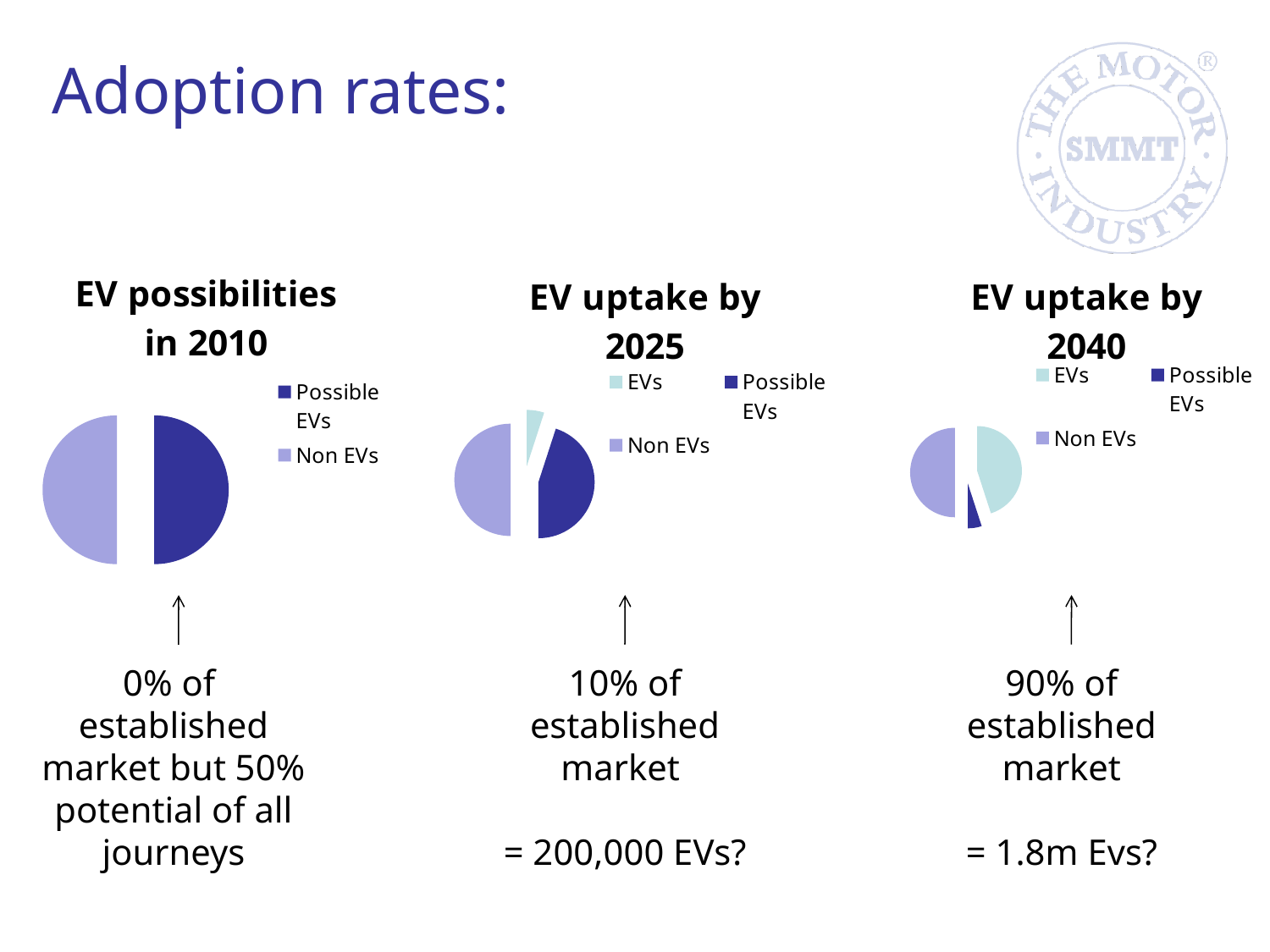
How many pie charts are shown on the slide? 3 Which legend entry appears in the 2025 and 2040 charts but not in the 2010 chart? EVs In the "EV uptake by 2040" chart, which slice is larger: Non EVs or Possible EVs? Non EVs How many entries does the legend of the "EV uptake by 2025" chart list? 3 In the "EV uptake by 2025" chart, which slice is larger: EVs or Non EVs? Non EVs What kind of chart is the "EV possibilities in 2010" chart? pie chart How many slices does the "EV uptake by 2040" pie chart have? 3 What is the title of the rightmost pie chart? EV uptake by 2040 In the "EV uptake by 2040" chart, which slice is the smallest? Possible EVs In the "EV uptake by 2025" chart, which slice is the smallest? EVs In the "EV uptake by 2040" chart, which slice is larger: EVs or Possible EVs? EVs How many entries does the legend of the "EV possibilities in 2010" chart list? 2